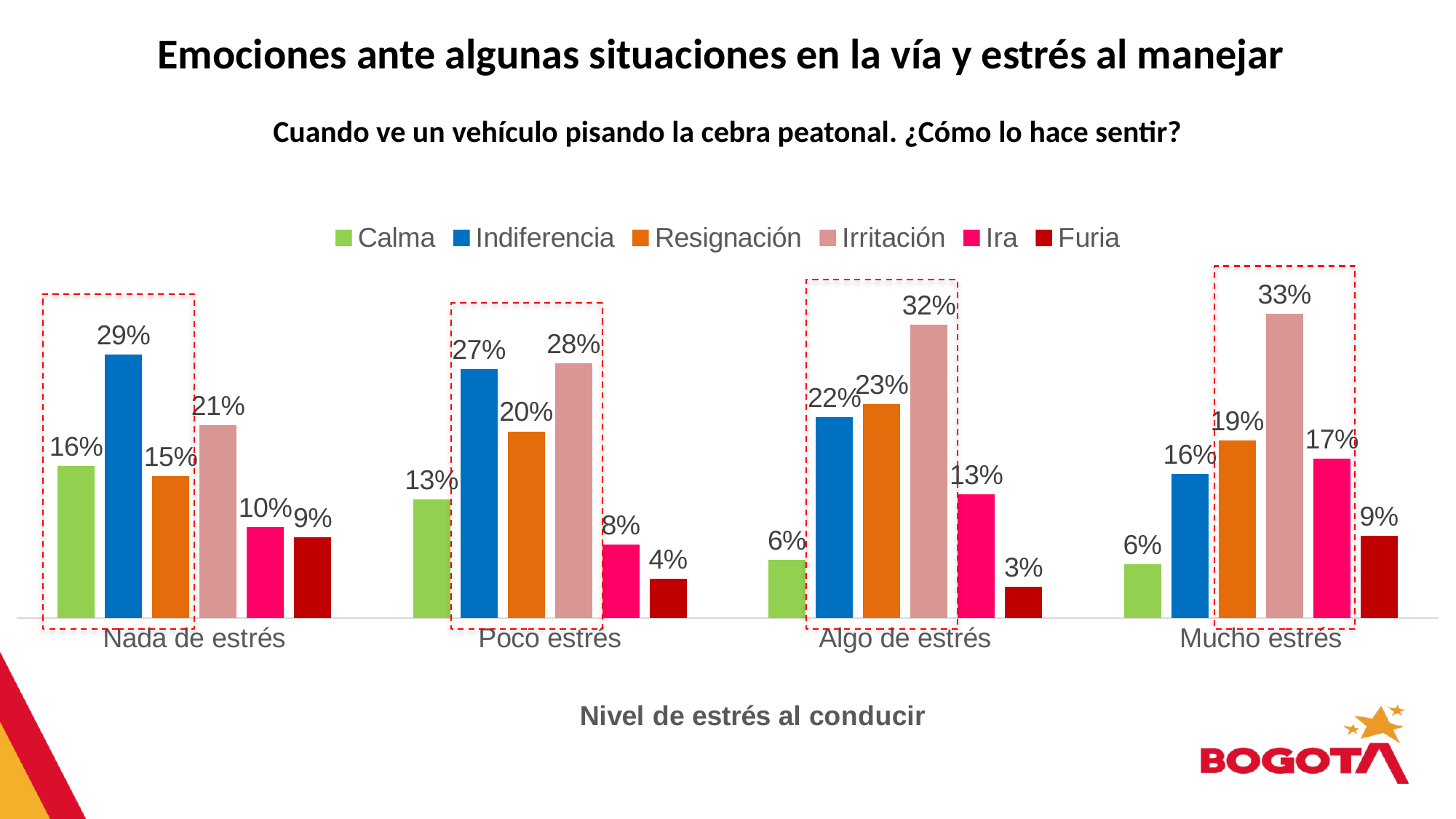
Which is larger in the Nada de estrés group, Calma or Resignación? Calma What is the value for Ira in the Poco estrés group? 8% Which series has the highest value in the Algo de estrés group? Irritación What is the difference between Irritación and Calma in the Mucho estrés group? 27% Do the values for Irritación rise or fall from Nada de estrés to Mucho estrés? Rise What kind of chart is shown on the slide? Bar chart How many series does the legend list? 6 What is the value for Irritación in the Mucho estrés group? 33% What is the value for Indiferencia in the Nada de estrés group? 29% What is the value for Furia in the Algo de estrés group? 3% Which series has the lowest value in the Poco estrés group? Furia How many stress-level categories are shown on the x axis? 4